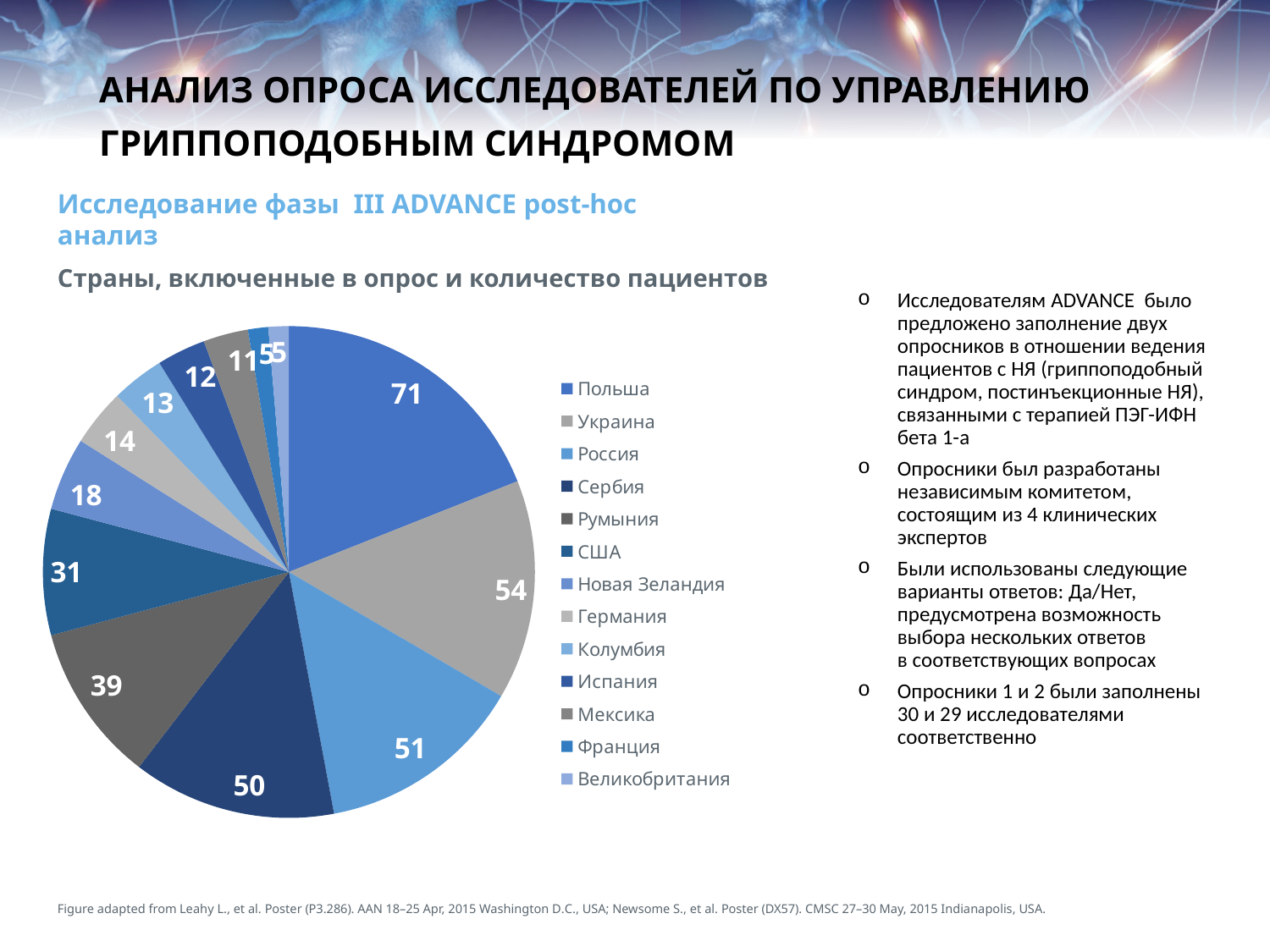
What is the difference between the values for Польша and Украина? 17 Which country has the largest slice in the pie chart? Польша What is the number of patients for Польша? 71 What is the number of patients for Румыния? 39 What is the number of patients for Новая Зеландия? 18 How many countries (slices) does the pie chart show? 13 Which has a larger value, США or Румыния? Румыния What is the title of the pie chart? Страны, включенные в опрос и количество пациентов What is the number of patients for Украина? 54 What kind of chart is shown on the slide? Pie chart Which has a larger value, Германия or Колумбия? Германия What is the difference between the values for Россия and Сербия? 1